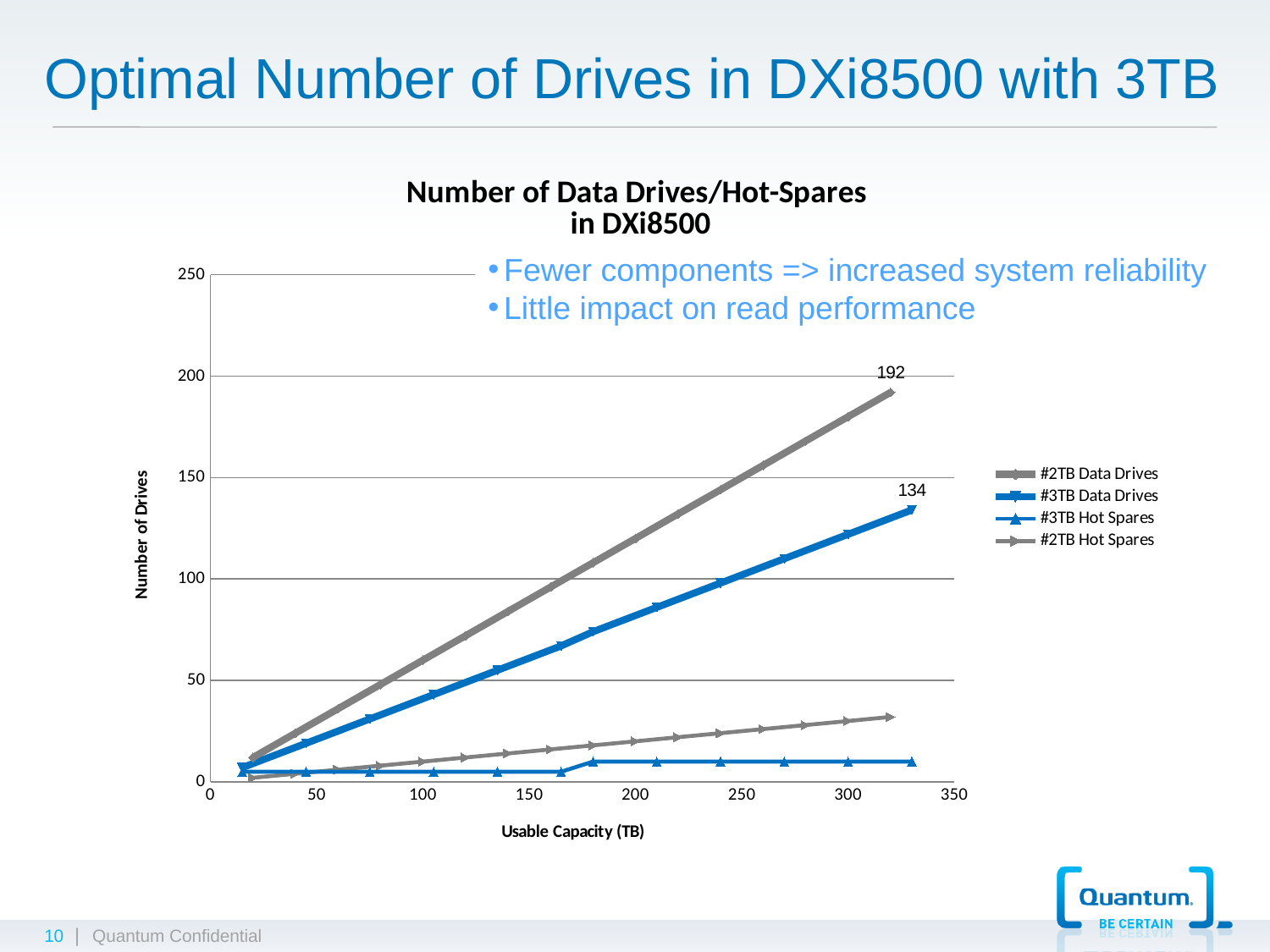
What kind of chart is shown on the slide? line chart Which series reaches the highest number of drives on the chart? #2TB Data Drives What is the label of the chart's x axis? Usable Capacity (TB) What is the labelled maximum value of the #3TB Data Drives series? 134 What is the title of the chart? Number of Data Drives/Hot-Spares in DXi8500 Does the #3TB Data Drives series rise or fall as usable capacity increases? rise What is the labelled maximum value of the #2TB Data Drives series? 192 What is the difference between the labelled maximum values of the #2TB Data Drives and #3TB Data Drives series? 58 Is the value for #2TB Hot Spares at around 320 TB greater or less than 50? less How many series does the chart legend list? 4 Which series has the lowest number of drives at the right end of the chart? #3TB Hot Spares At the highest usable capacity shown, which is larger: the #2TB Data Drives value or the #3TB Data Drives value? #2TB Data Drives